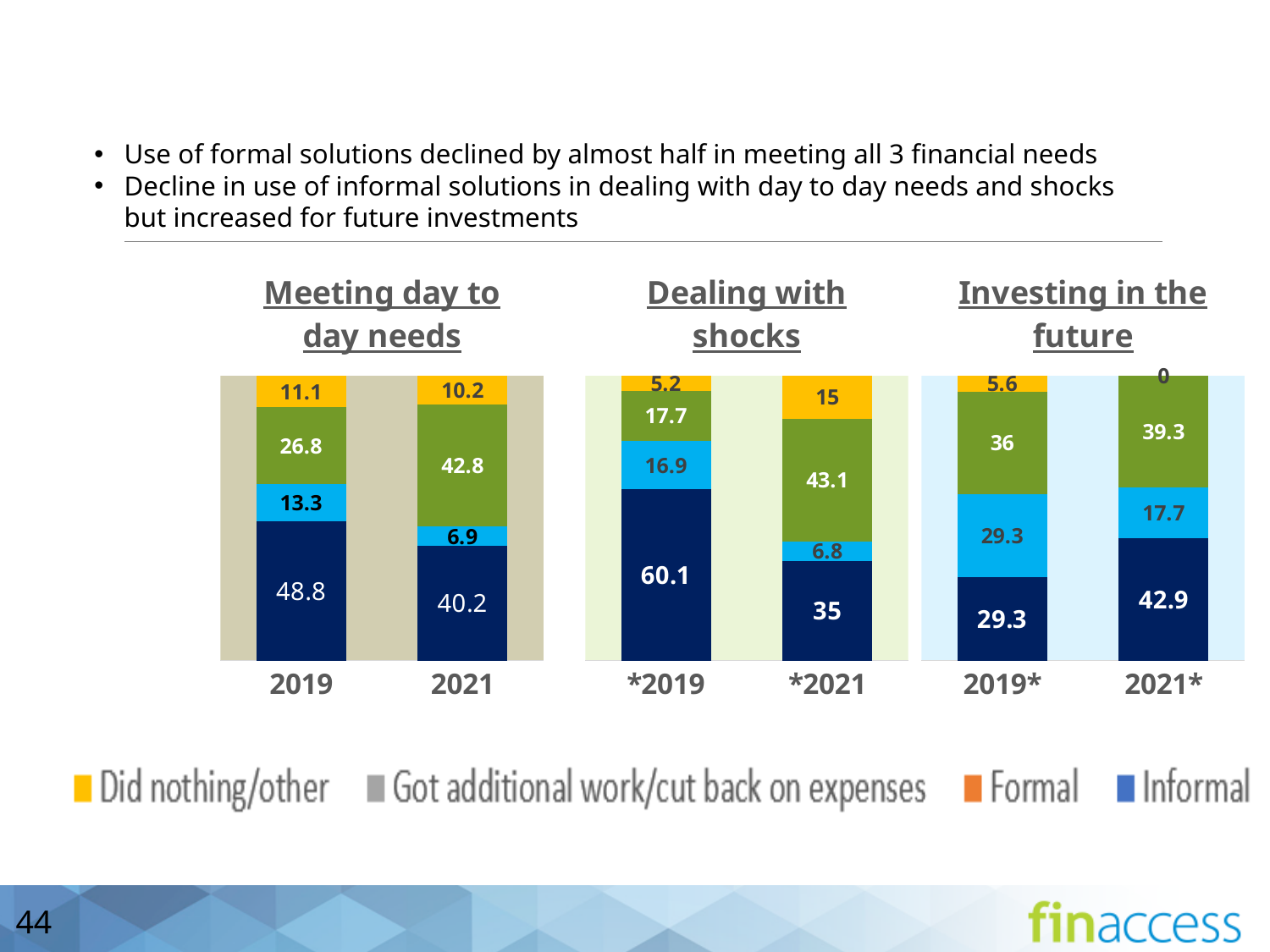
What kind of chart is used on this slide? Stacked bar chart In the 'Investing in the future' chart, what is the value of the yellow top segment for 2021*? 0 How many series does the legend list? 4 In the 'Dealing with shocks' chart, by how much did the dark blue bottom segment fall from *2019 to *2021? 25.1 How many bars are shown in the 'Investing in the future' chart? 2 In the 'Dealing with shocks' chart, which segment is the largest in the *2019 bar? The dark blue bottom segment (60.1) In the 'Dealing with shocks' chart, what is the value of the yellow top segment for *2021? 15 In the 'Investing in the future' chart, which year has the larger dark blue bottom segment, 2019* or 2021*? 2021* In the 'Meeting day to day needs' chart, what is the value of the dark blue bottom segment for 2019? 48.8 In the 'Meeting day to day needs' chart, what is the value of the green segment for 2021? 42.8 What is the total of the 2019 stacked bar in the 'Meeting day to day needs' chart? 100 In the 'Meeting day to day needs' chart, what is the difference between the light blue segment values for 2019 and 2021? 6.4